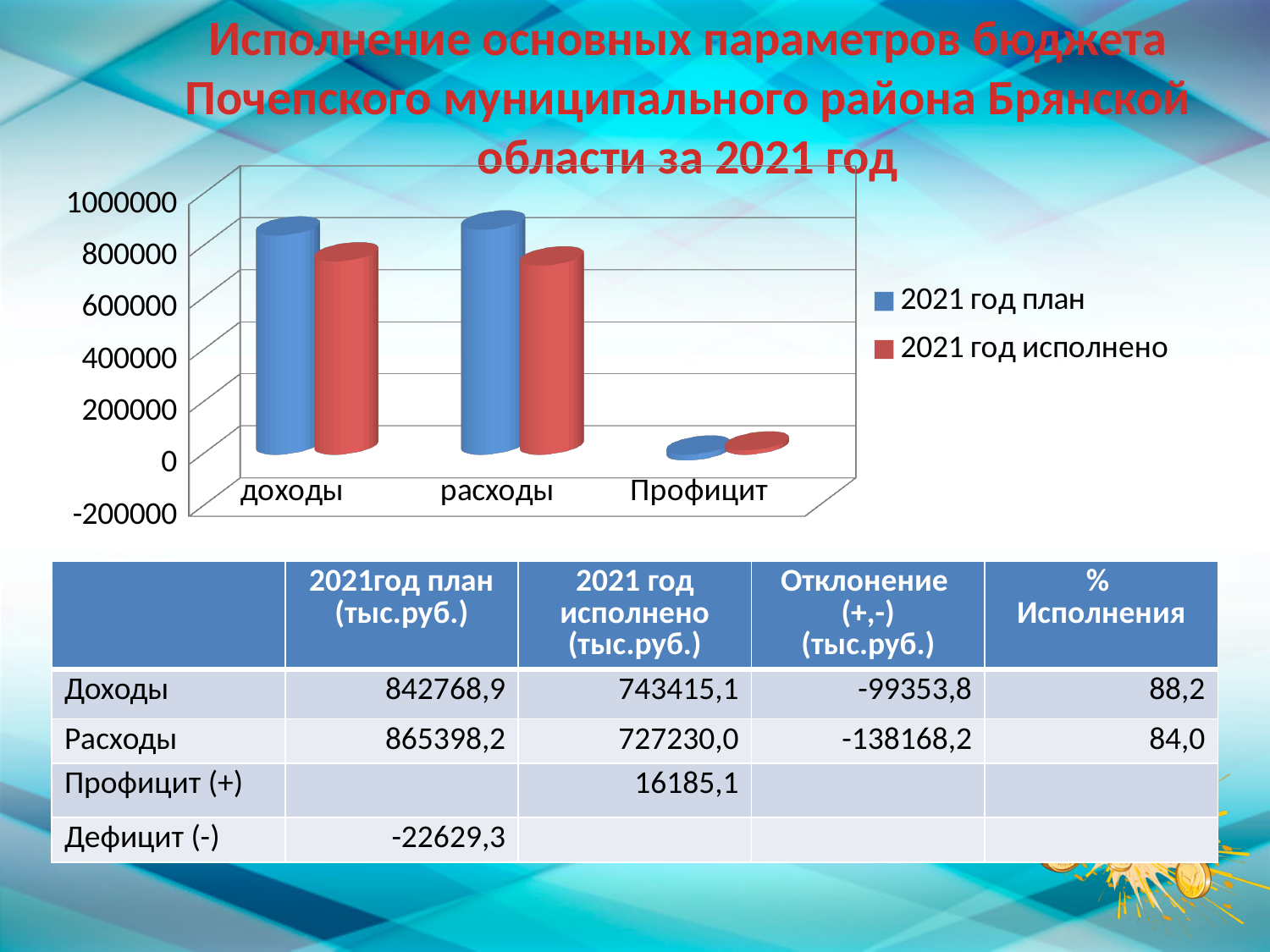
For доходы, which is larger: the 2021 год план bar or the 2021 год исполнено bar? 2021 год план How many series does the chart legend list? 2 Is the 2021 год план value for доходы greater or less than 600000? greater What are the two series listed in the chart legend? 2021 год план and 2021 год исполнено What kind of chart is shown on the slide? bar chart Is the 2021 год исполнено value for расходы greater or less than 800000? less Which category has the lowest bars in the chart? Профицит According to the table below the chart, what is the 2021 год план value for Доходы (тыс.руб.)? 842768,9 How many categories are shown on the x axis of the chart? 3 Which colour represents the series 2021 год план in the chart? blue Is the 2021 год исполнено value for Профицит greater or less than 200000? less According to the table below the chart, what is the 2021 год исполнено value for Расходы (тыс.руб.)? 727230,0